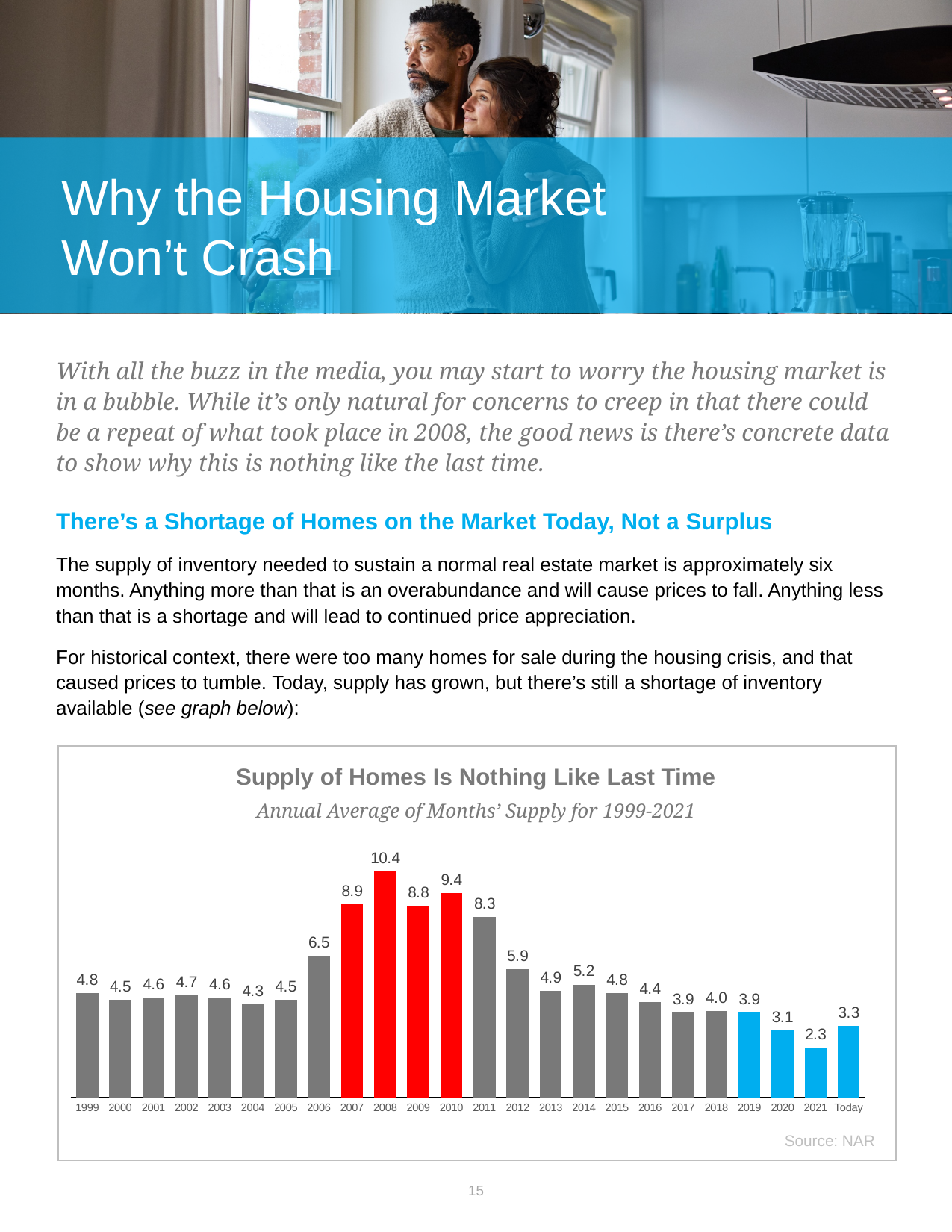
Do the values rise or fall from 2011 to 2021? Fall How many bars are plotted in the chart? 24 Which is larger, the value for 2010 or the value for 2009? 2010 Which year has the lowest months' supply? 2021 What is the difference between the 2008 value and the Today value? 7.1 What is the value shown for Today? 3.3 Which years are shown with red bars? 2007, 2008, 2009, 2010 What type of chart is shown? Bar chart What is the title of the chart? Supply of Homes Is Nothing Like Last Time What is the months' supply value for 2021? 2.3 Which year has the highest months' supply? 2008 What is the months' supply value for 2008? 10.4